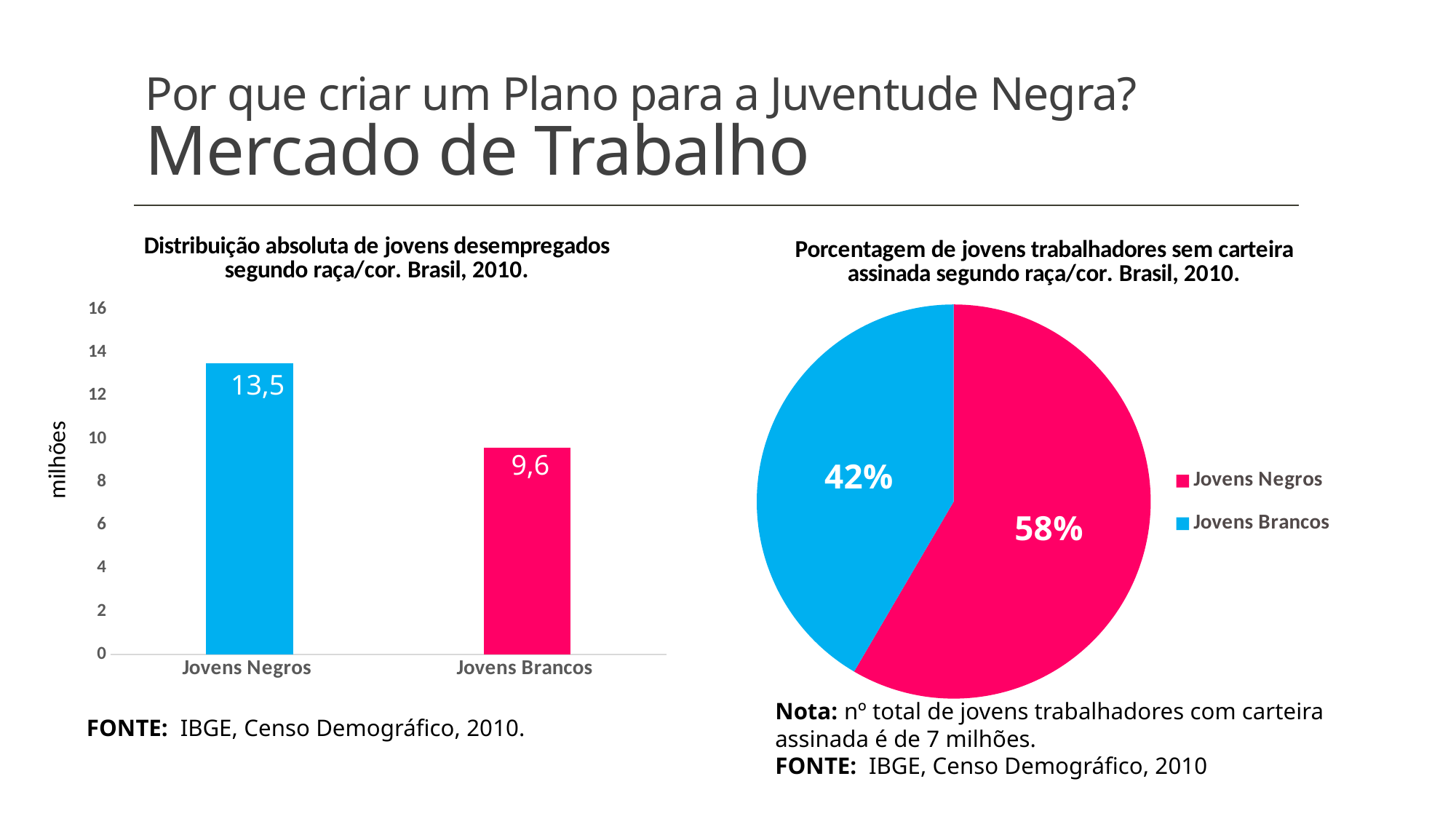
In the pie chart on the right, which slice is larger, Jovens Negros or Jovens Brancos? Jovens Negros In the bar chart on the left, which category has the highest value? Jovens Negros What is the y-axis label of the bar chart on the left? milhões In the bar chart on the left, what is the value for Jovens Negros? 13,5 In the bar chart on the left, what is the value for Jovens Brancos? 9,6 In the bar chart on the left, what is the difference between the values for Jovens Negros and Jovens Brancos? 3,9 What type of chart is the chart on the left? bar chart In the pie chart on the right, what share does Jovens Negros have? 58% In the bar chart on the left, which category has the lowest value? Jovens Brancos In the pie chart on the right, what share does Jovens Brancos have? 42% In the bar chart on the left, is the value for Jovens Brancos greater or less than 10? less How many categories are shown in the bar chart on the left? 2